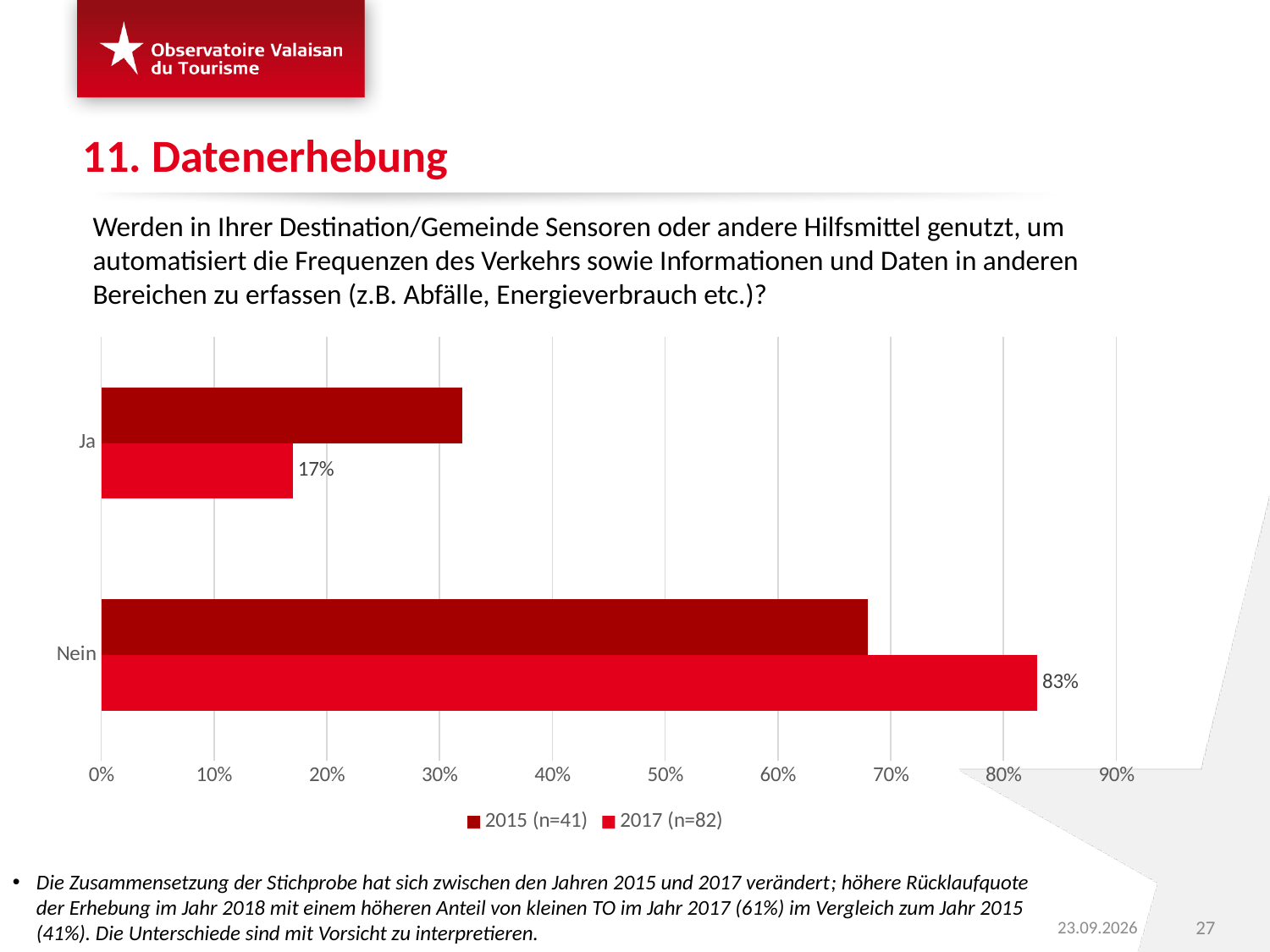
Which category has the highest value in the 2017 (n=82) series? Nein What is the value for "Nein" in the 2017 (n=82) series? 83% How many categories are shown on the chart? 2 What kind of chart is shown on the slide? Bar chart For the category "Nein", which series has the larger value, 2015 (n=41) or 2017 (n=82)? 2017 (n=82) Is the value for "Nein" in the 2015 (n=41) series greater or less than 60%? greater Is the value for "Ja" in the 2015 (n=41) series greater or less than 20%? greater What is the value for "Ja" in the 2017 (n=82) series? 17% For the category "Ja", which series has the larger value, 2015 (n=41) or 2017 (n=82)? 2015 (n=41) What is the difference between the 2017 (n=82) values for "Nein" and "Ja"? 66 percentage points What are the two entries in the chart legend? 2015 (n=41) and 2017 (n=82) How many series does the legend list? 2